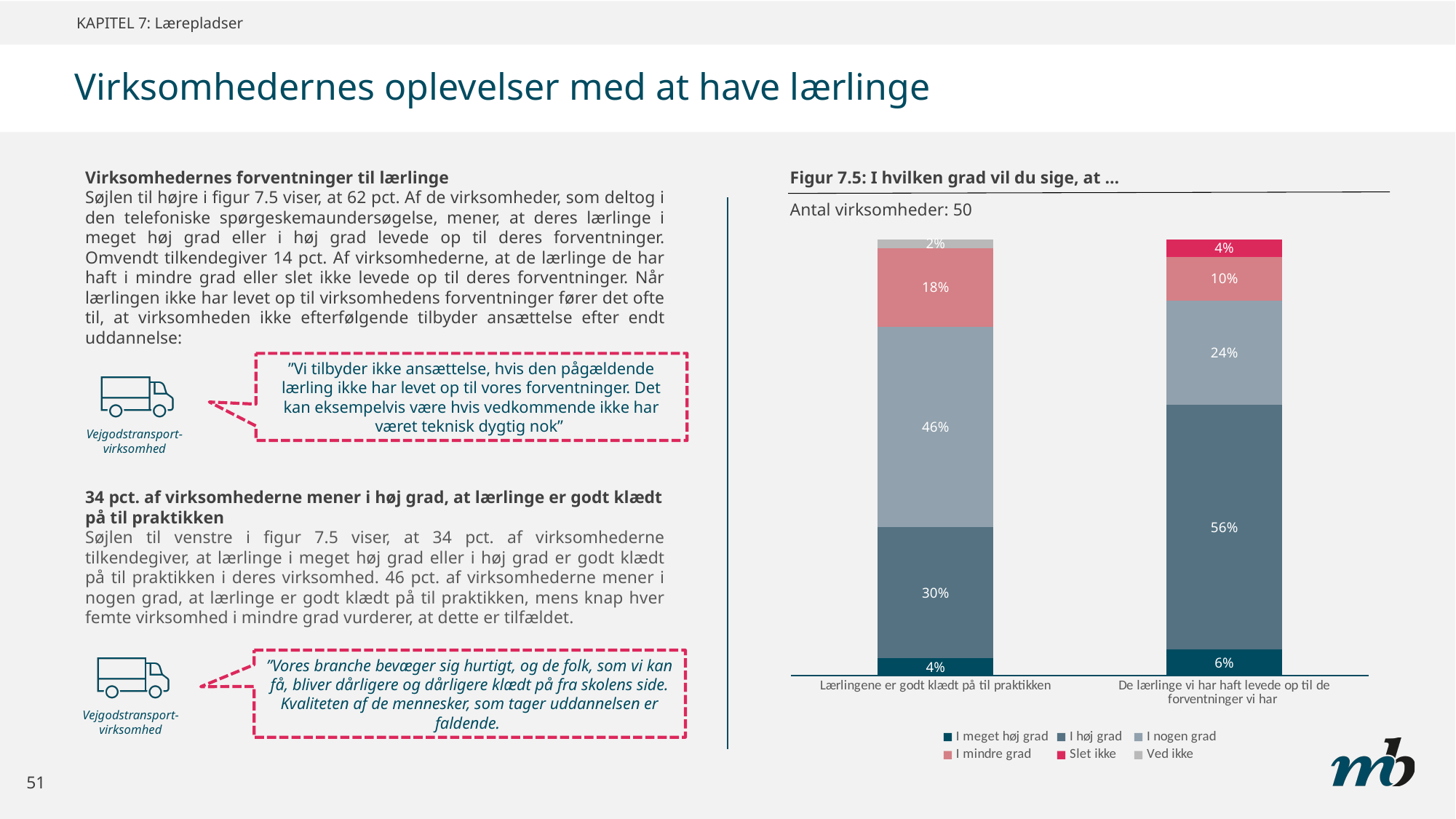
In Figur 7.5, what is the value for 'I høj grad' in the bar 'De lærlinge vi har haft levede op til de forventninger vi har'? 56% In Figur 7.5, which bar has the larger 'I mindre grad' value? Lærlingene er godt klædt på til praktikken In Figur 7.5, which segment is the largest in the bar 'De lærlinge vi har haft levede op til de forventninger vi har'? I høj grad How many categories (bars) are shown in Figur 7.5? 2 In Figur 7.5, what is the value for 'I mindre grad' in the bar 'De lærlinge vi har haft levede op til de forventninger vi har'? 10% What kind of chart is shown in Figur 7.5? Stacked bar chart According to the subtitle of Figur 7.5, how many companies (virksomheder) are included? 50 In Figur 7.5, what is the value for 'I nogen grad' in the bar 'Lærlingene er godt klædt på til praktikken'? 46% How many series does the legend of Figur 7.5 list? 6 In Figur 7.5, what is the value for 'I meget høj grad' in the bar 'Lærlingene er godt klædt på til praktikken'? 4% In Figur 7.5, which segment is the smallest in the bar 'Lærlingene er godt klædt på til praktikken'? Ved ikke In Figur 7.5, what is the difference between the 'I høj grad' values of the two bars? 26 percentage points